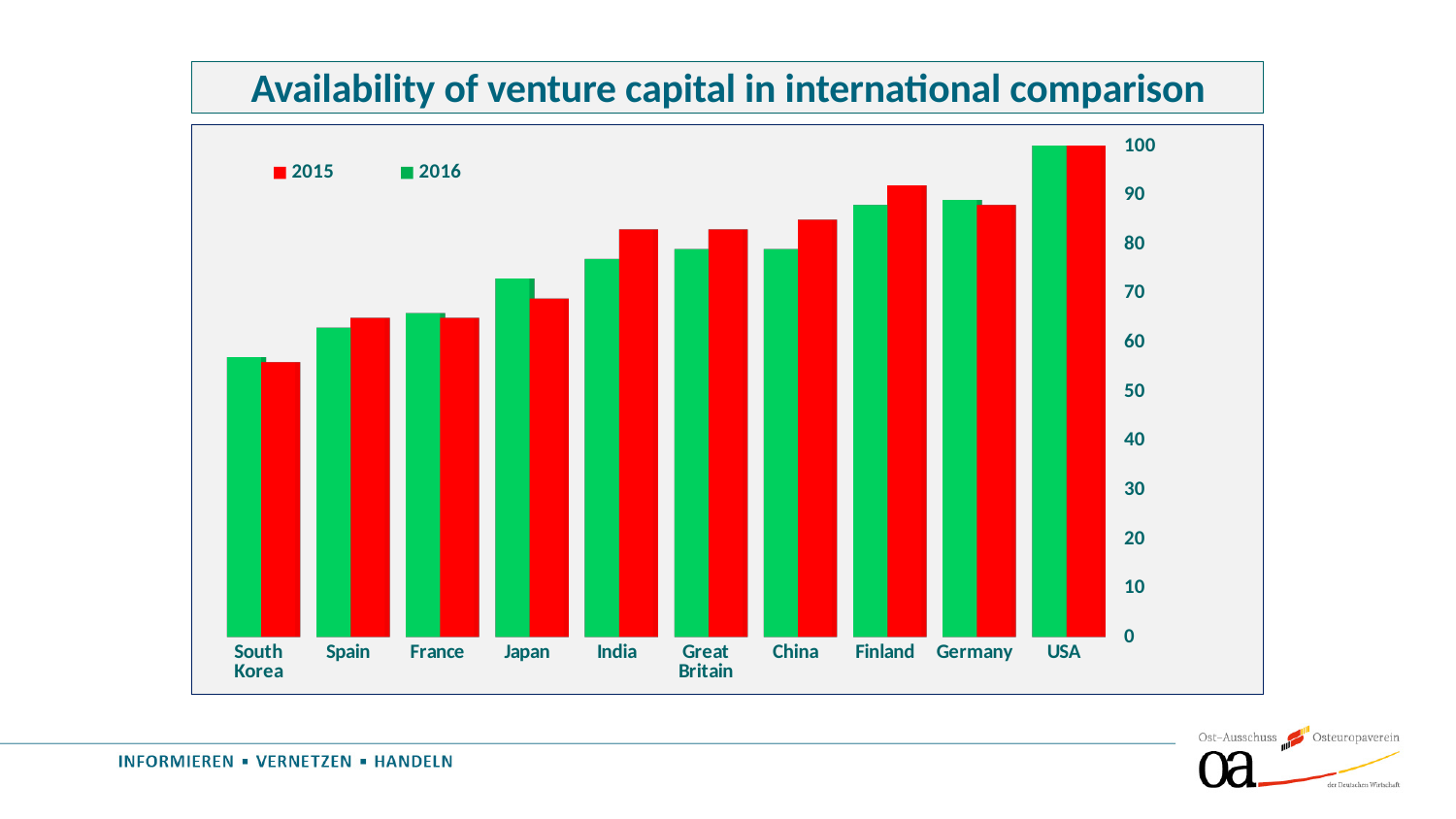
Which country has the highest value for 2016? USA What is the value for the USA in 2016? 100 How many series does the legend list? 2 What is the title of the chart? Availability of venture capital in international comparison For India, which year has the larger value, 2015 or 2016? 2015 Which country has the lowest value for 2015? South Korea Do the values generally rise or fall from South Korea on the left to the USA on the right? rise How many countries are shown on the x axis of the chart? 10 Is the 2016 value for Spain greater or less than 70? less Is the 2015 value for South Korea greater or less than 60? less What kind of chart is shown on the slide? bar chart Is the 2016 value for Japan greater or less than 70? greater